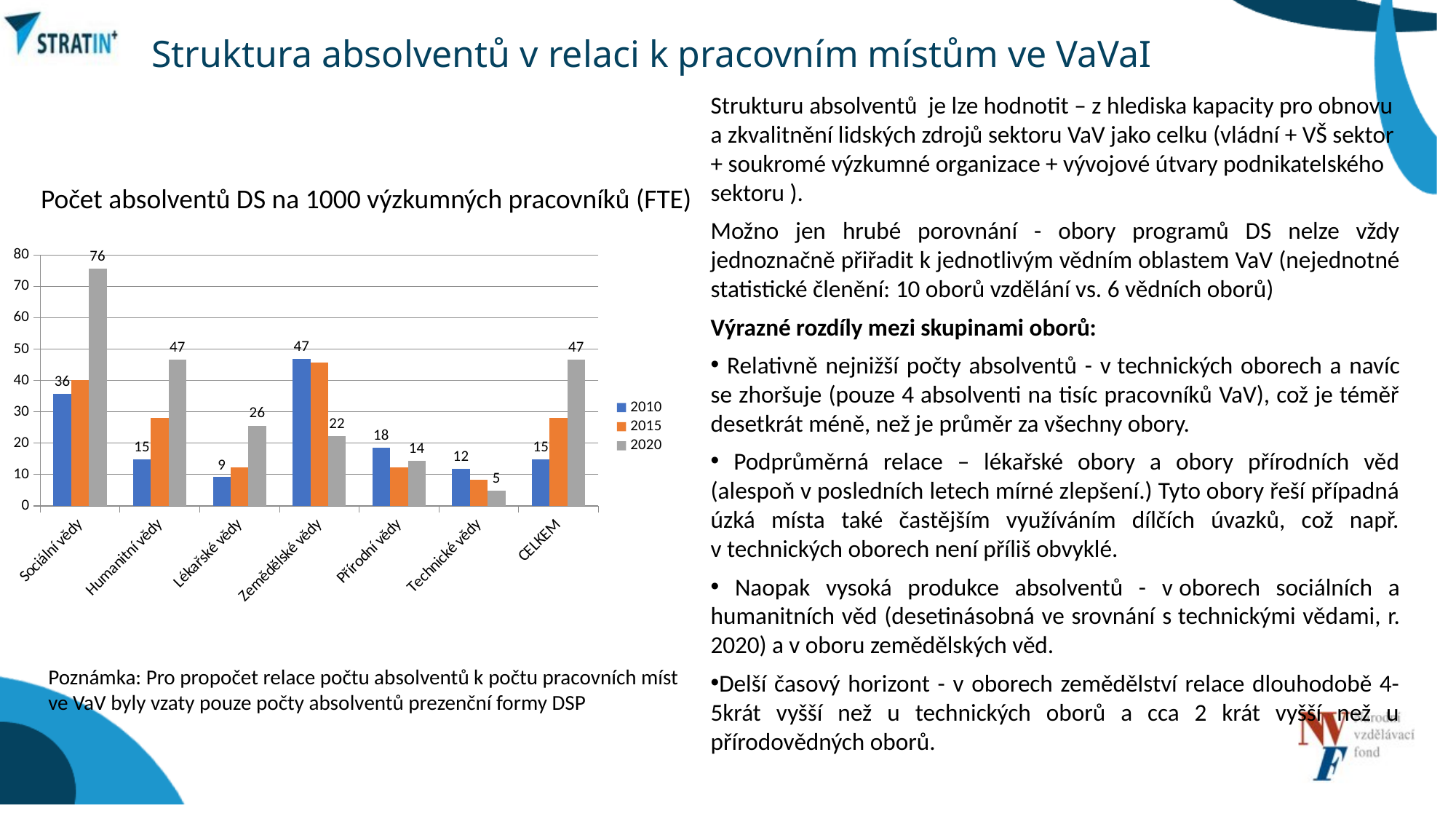
What kind of chart is shown on the slide? bar chart Is the value for Technické vědy in 2015 greater or less than 10? less What is the difference between the 2020 and 2010 values for CELKEM? 32 What is the value for Sociální vědy in 2020? 76 How many series does the legend list? 3 For Zemědělské vědy, which year has the larger value, 2010 or 2020? 2010 How many categories are shown on the x axis? 7 What is the value for Technické vědy in 2020? 5 Which category has the lowest value in 2020? Technické vědy What is the value for Zemědělské vědy in 2010? 47 What is the difference between the 2020 and 2010 values for Sociální vědy? 40 Which category has the highest value in 2020? Sociální vědy